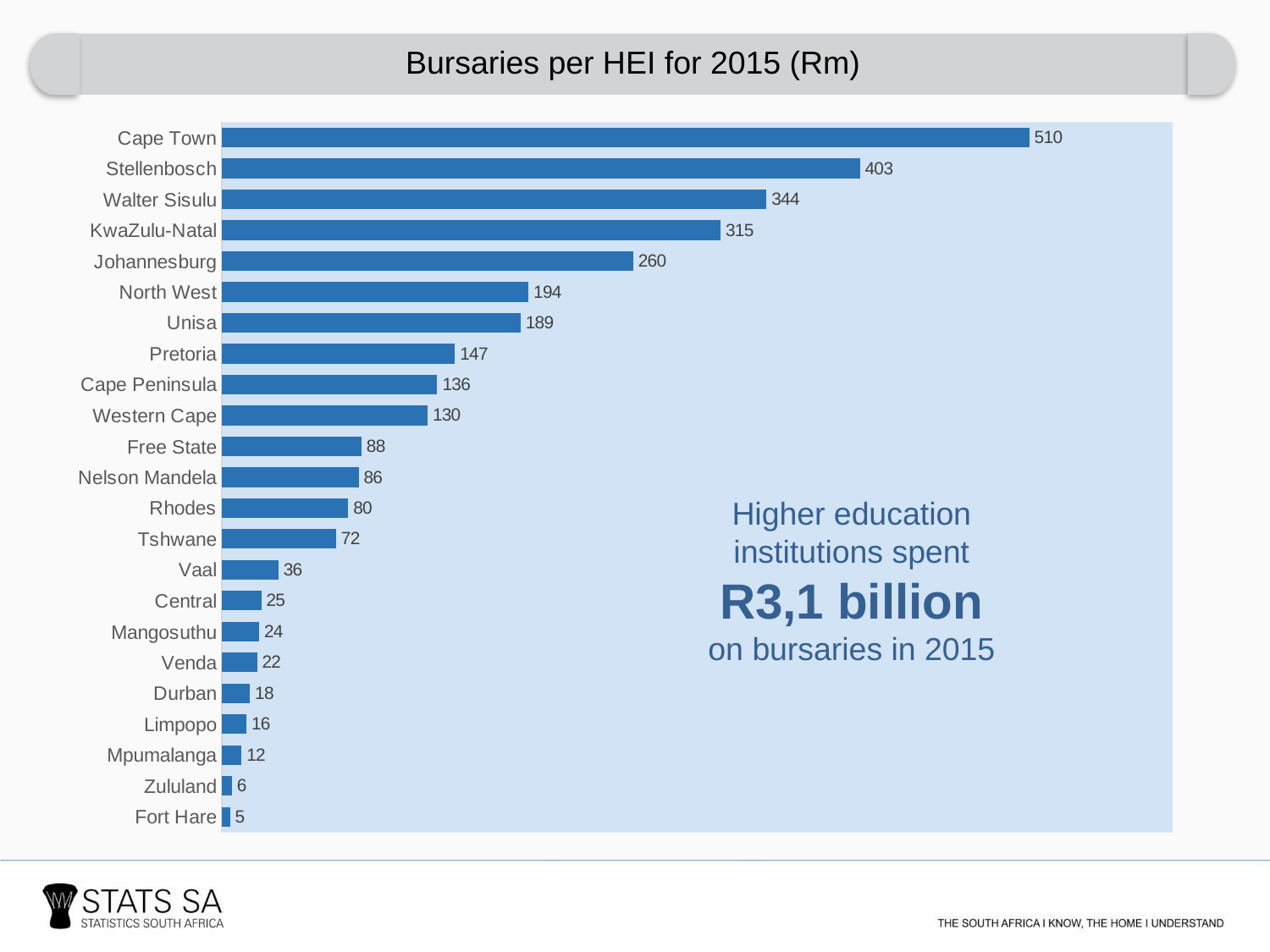
Which has a larger bursary value, Vaal or Tshwane? Tshwane What is the title of the chart? Bursaries per HEI for 2015 (Rm) Which HEI has the lowest bursary value? Fort Hare How many HEIs are shown in the chart? 23 What is the difference between the bursary values for Cape Town and Stellenbosch? 107 What is the difference between the bursary values for Johannesburg and North West? 66 Which has a larger bursary value, Walter Sisulu or KwaZulu-Natal? Walter Sisulu What is the bursary value for Pretoria? 147 What is the bursary value for Mangosuthu? 24 What is the bursary value for Stellenbosch? 403 What kind of chart is shown on the slide? Bar chart Which HEI has the highest bursary value? Cape Town